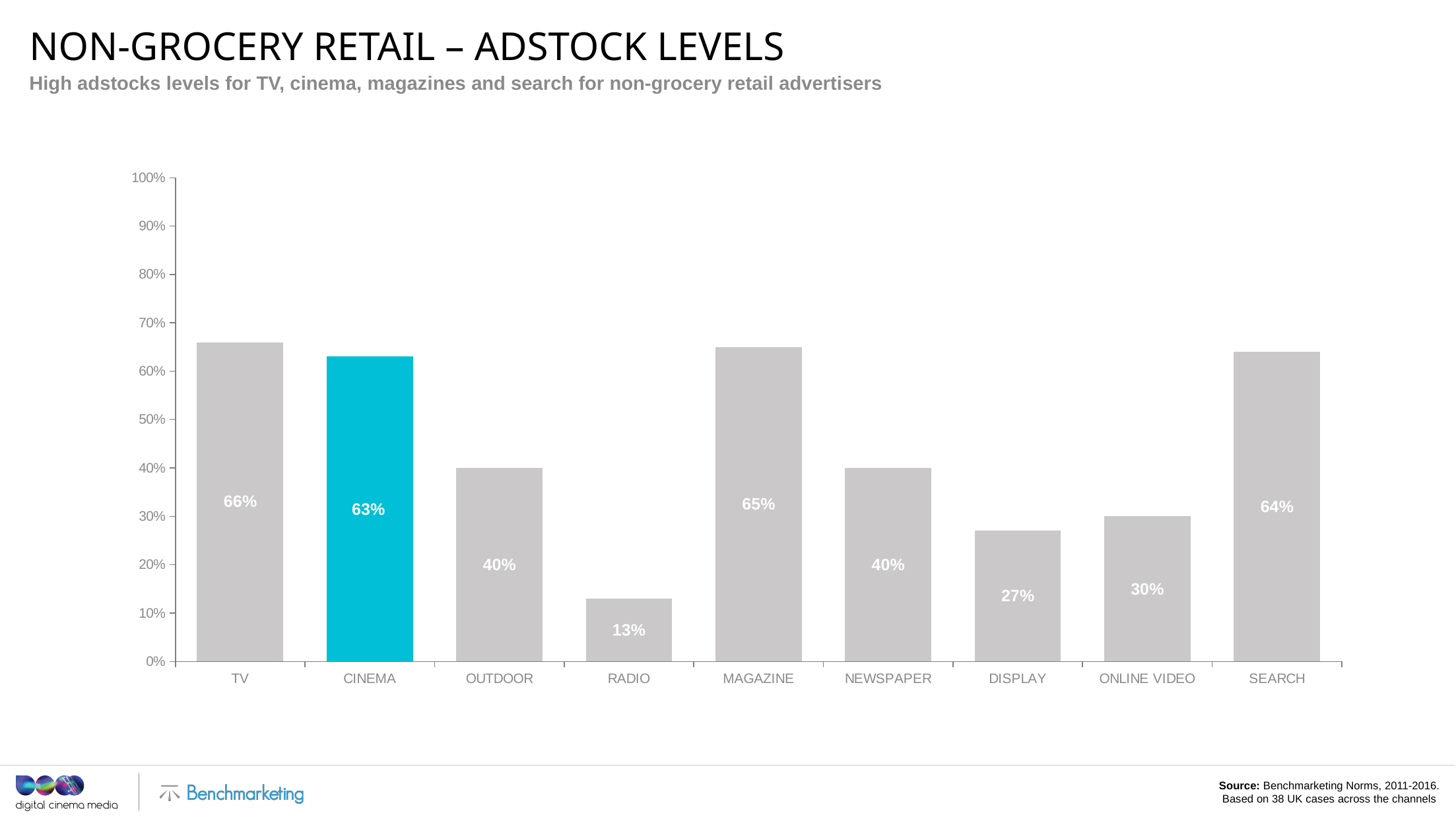
What is the adstock level for CINEMA? 63% What is the difference between the adstock levels for TV and CINEMA? 3% Is the value for DISPLAY greater or less than 50%? less How many channels are shown on the chart? 9 Which channel has the lowest adstock level? RADIO What kind of chart is shown on the slide? bar chart What is the adstock level for RADIO? 13% What is the adstock level for ONLINE VIDEO? 30% Which bar is highlighted in a different colour (blue) from the others? CINEMA Which channel has the highest adstock level? TV Which has a higher adstock level, SEARCH or OUTDOOR? SEARCH What is the difference between the adstock levels for MAGAZINE and DISPLAY? 38%